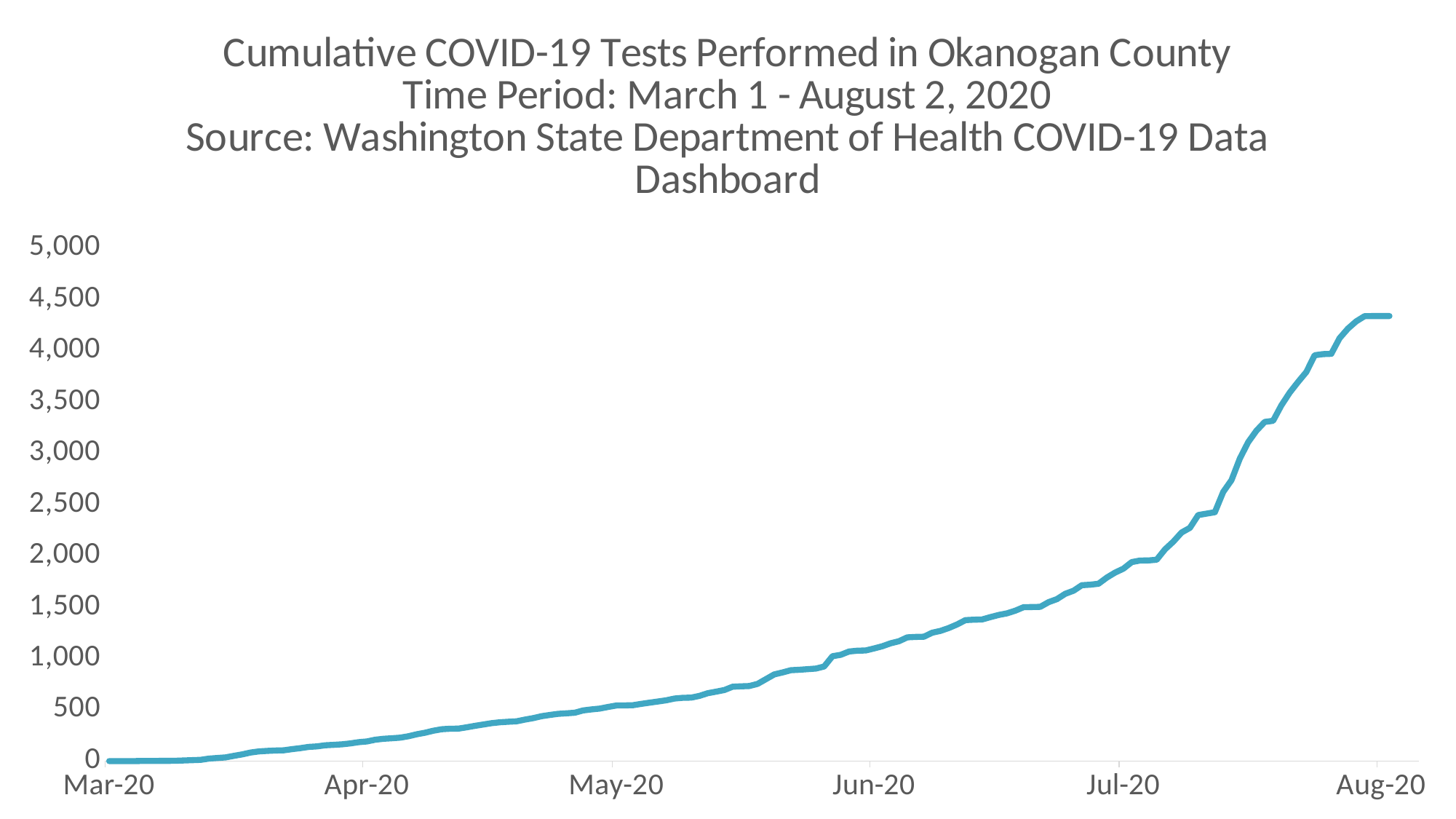
Is the value at Jul-20 greater or less than 2,500? less At which x-axis label is the line at its lowest value? Mar-20 What is the highest tick value shown on the y axis? 5,000 Do the cumulative test values rise or fall from Mar-20 to Aug-20? rise Is the value at Apr-20 greater or less than 500? less Is the value at Jun-20 greater or less than 2,000? less What kind of chart is shown on the slide? line chart Which is larger, the value at Jun-20 or the value at Jul-20? Jul-20 At which x-axis label does the line reach its highest value? Aug-20